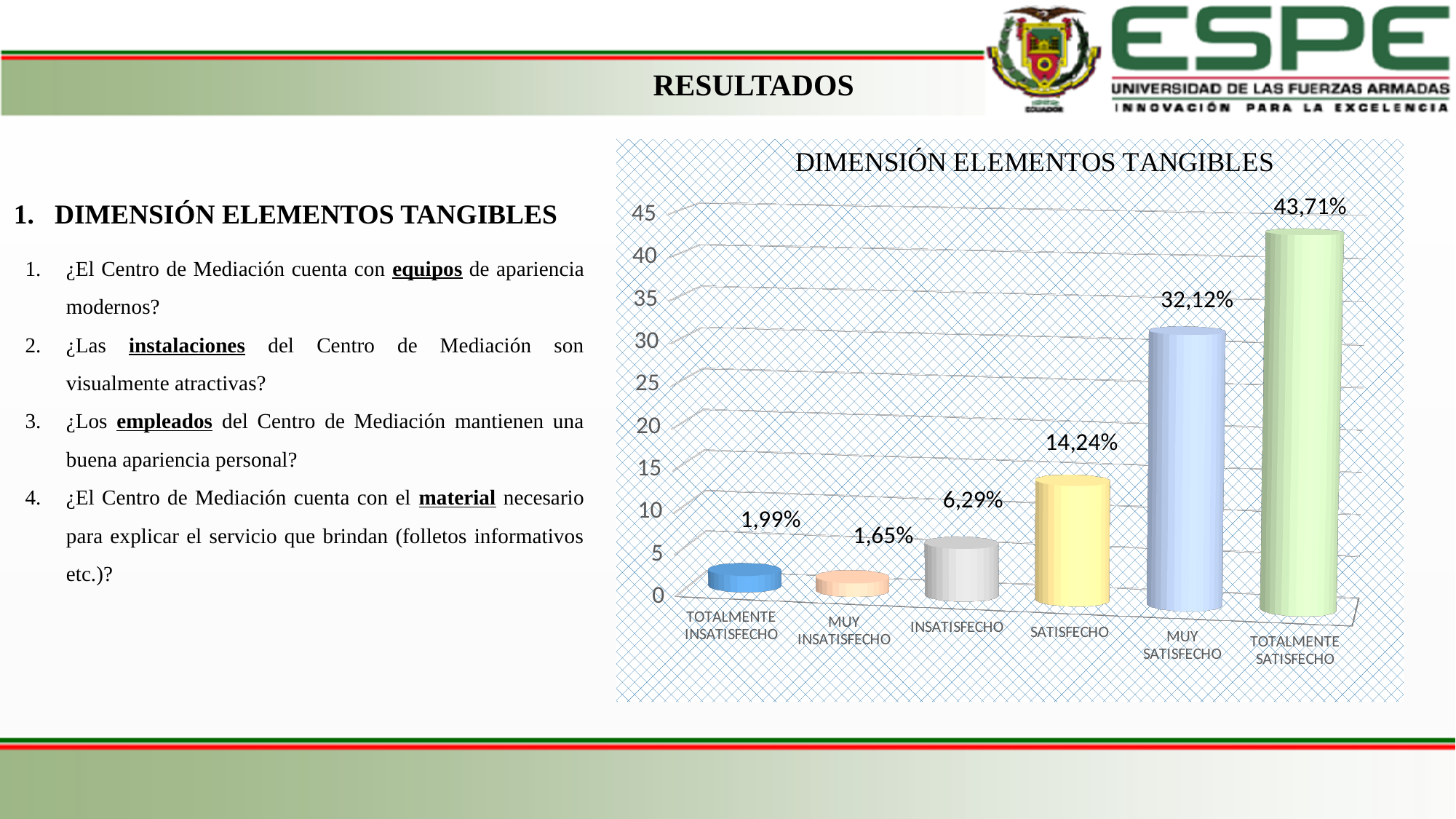
Do the values rise or fall moving from left to right along the x axis from MUY INSATISFECHO to TOTALMENTE SATISFECHO? Rise What is the value for MUY INSATISFECHO? 1,65% Which category has the lowest value? MUY INSATISFECHO What is the difference between the values for TOTALMENTE SATISFECHO and MUY SATISFECHO? 11,59% Which is larger, the value for SATISFECHO or the value for INSATISFECHO? SATISFECHO What is the value for MUY SATISFECHO? 32,12% Which category has the highest value? TOTALMENTE SATISFECHO What is the title of the chart? DIMENSIÓN ELEMENTOS TANGIBLES How many categories are shown on the x axis of the chart? 6 What kind of chart is shown on the slide? Bar chart What is the value for INSATISFECHO? 6,29% What is the value for TOTALMENTE SATISFECHO? 43,71%